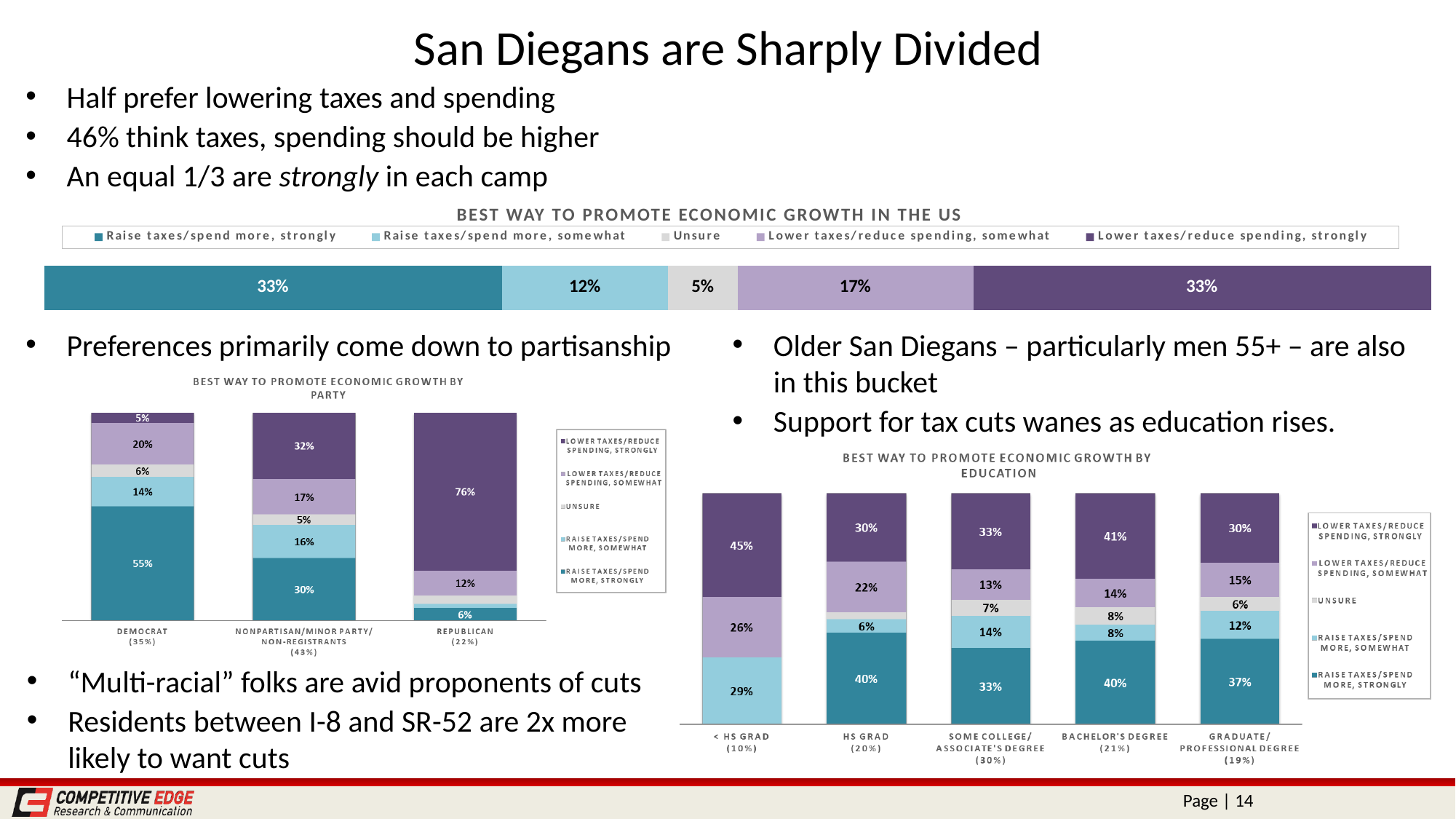
What type of chart is the 'Best Way to Promote Economic Growth by Education' chart? Stacked bar chart In the 'Best Way to Promote Economic Growth by Party' chart, what share of Republicans chose 'Lower taxes/reduce spending, strongly'? 76% In the 'Best Way to Promote Economic Growth in the US' chart, what share chose 'Raise taxes/spend more, strongly'? 33% In the 'Best Way to Promote Economic Growth by Education' chart, which is larger: the 'Lower taxes/reduce spending, strongly' share for HS Grad or for Bachelor's Degree? Bachelor's Degree In the 'Best Way to Promote Economic Growth by Party' chart, what share of Democrats chose 'Raise taxes/spend more, strongly'? 55% In the 'Best Way to Promote Economic Growth by Party' chart, what is the difference between the Democrat and Nonpartisan 'Raise taxes/spend more, strongly' shares? 25% In the 'Best Way to Promote Economic Growth in the US' chart, what share is 'Unsure'? 5% In the 'Best Way to Promote Economic Growth by Education' chart, what share of those with a Bachelor's degree chose 'Raise taxes/spend more, strongly'? 40% In the 'Best Way to Promote Economic Growth by Education' chart, what share of those with less than a HS grad education chose 'Lower taxes/reduce spending, strongly'? 45% How many party categories are shown in the 'Best Way to Promote Economic Growth by Party' chart? 3 How many series does the legend of the 'Best Way to Promote Economic Growth in the US' chart list? 5 In the 'Best Way to Promote Economic Growth by Party' chart, which party group has the highest 'Lower taxes/reduce spending, strongly' share? Republican